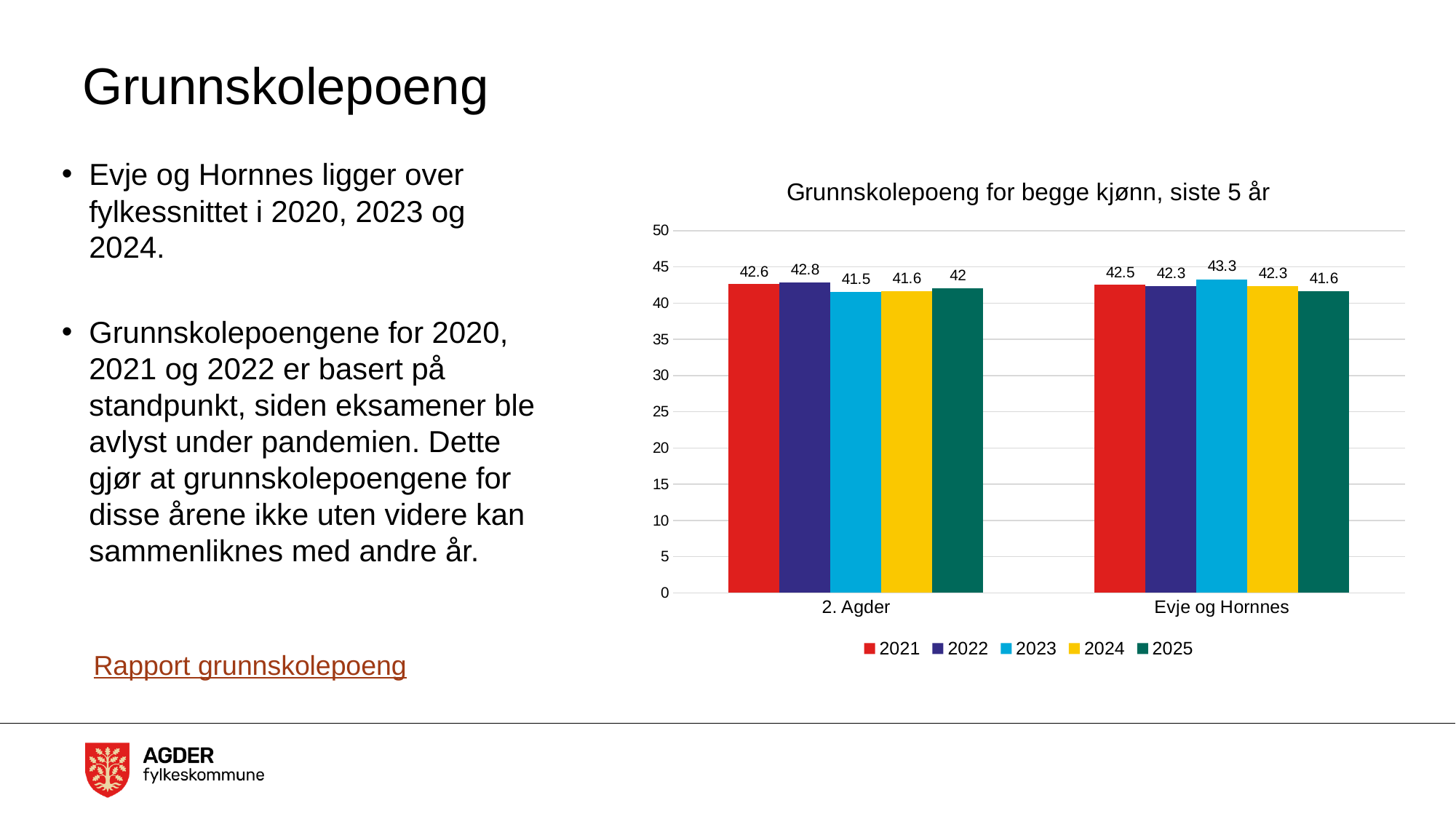
What kind of chart is shown on the slide? Bar chart Which year has the highest value for Evje og Hornnes? 2023 What is the difference between the 2023 values for Evje og Hornnes and 2. Agder? 1.8 How many series does the legend list? 5 How many categories are shown on the x axis? 2 What is the value for 2. Agder in 2021? 42.6 Which year has the lowest value for 2. Agder? 2023 Which is larger, the 2022 value for 2. Agder or the 2022 value for Evje og Hornnes? 2. Agder What is the value for Evje og Hornnes in 2025? 41.6 What is the value for 2. Agder in 2025? 42 What is the value for Evje og Hornnes in 2023? 43.3 What is the title of the chart? Grunnskolepoeng for begge kjønn, siste 5 år